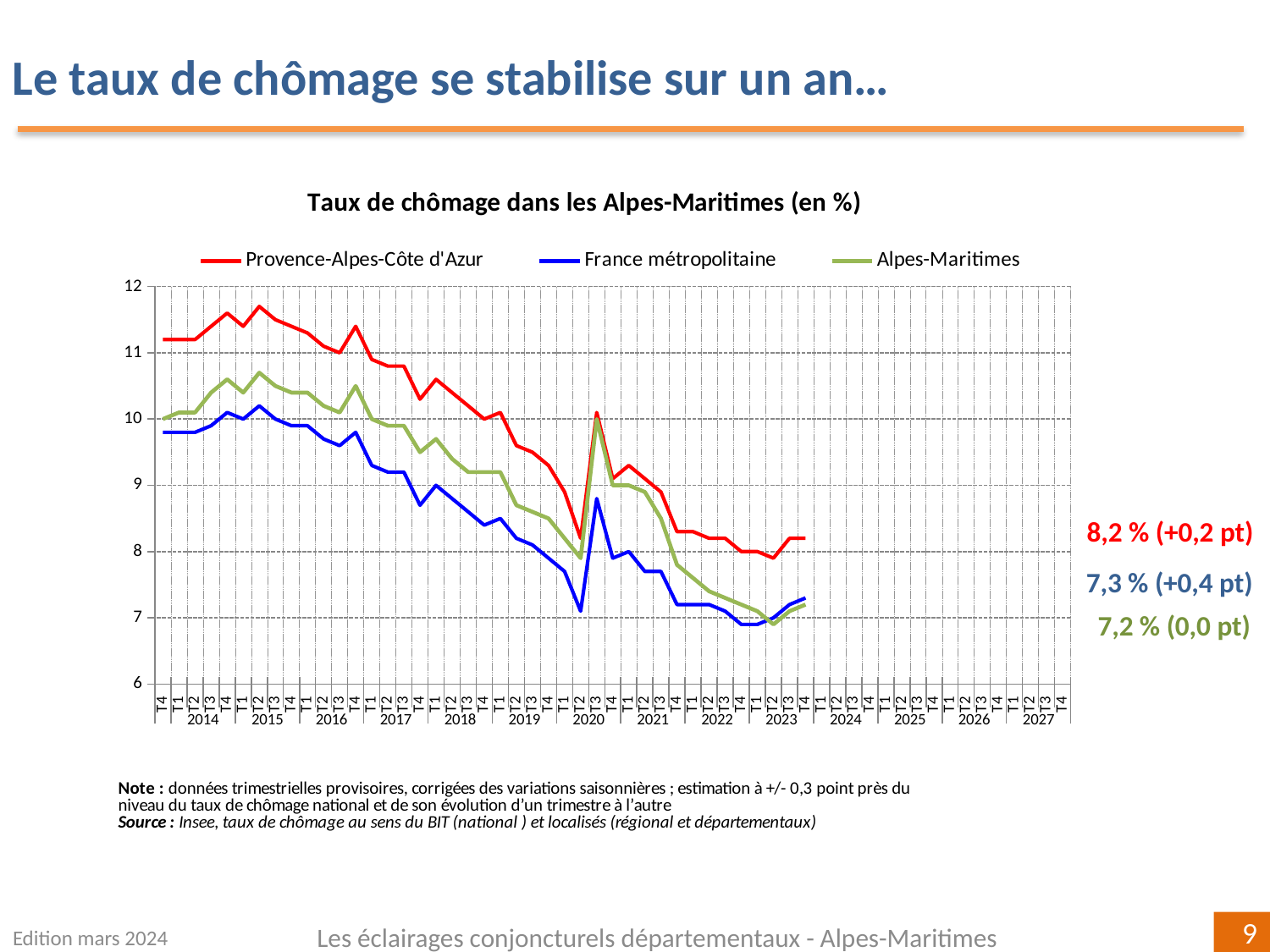
What is the latest unemployment rate shown for France métropolitaine? 7,3 % Overall, do the unemployment rates rise or fall between 2014 and 2023? fall How many series does the legend list? 3 What is the latest unemployment rate shown for Alpes-Maritimes? 7,2 % Is the value for Provence-Alpes-Côte d'Azur in T2 2015 greater or less than 11? greater Is the value for France métropolitaine in T2 2020 greater or less than 8? less What is the difference between the latest values for Provence-Alpes-Côte d'Azur and Alpes-Maritimes? 1,0 point What is the title of the chart? Taux de chômage dans les Alpes-Maritimes (en %) What one-year change is shown next to the France métropolitaine value? +0,4 pt What is the latest unemployment rate shown for Provence-Alpes-Côte d'Azur? 8,2 % What kind of chart is shown on the slide? line chart Which series has the highest latest value: Provence-Alpes-Côte d'Azur or Alpes-Maritimes? Provence-Alpes-Côte d'Azur